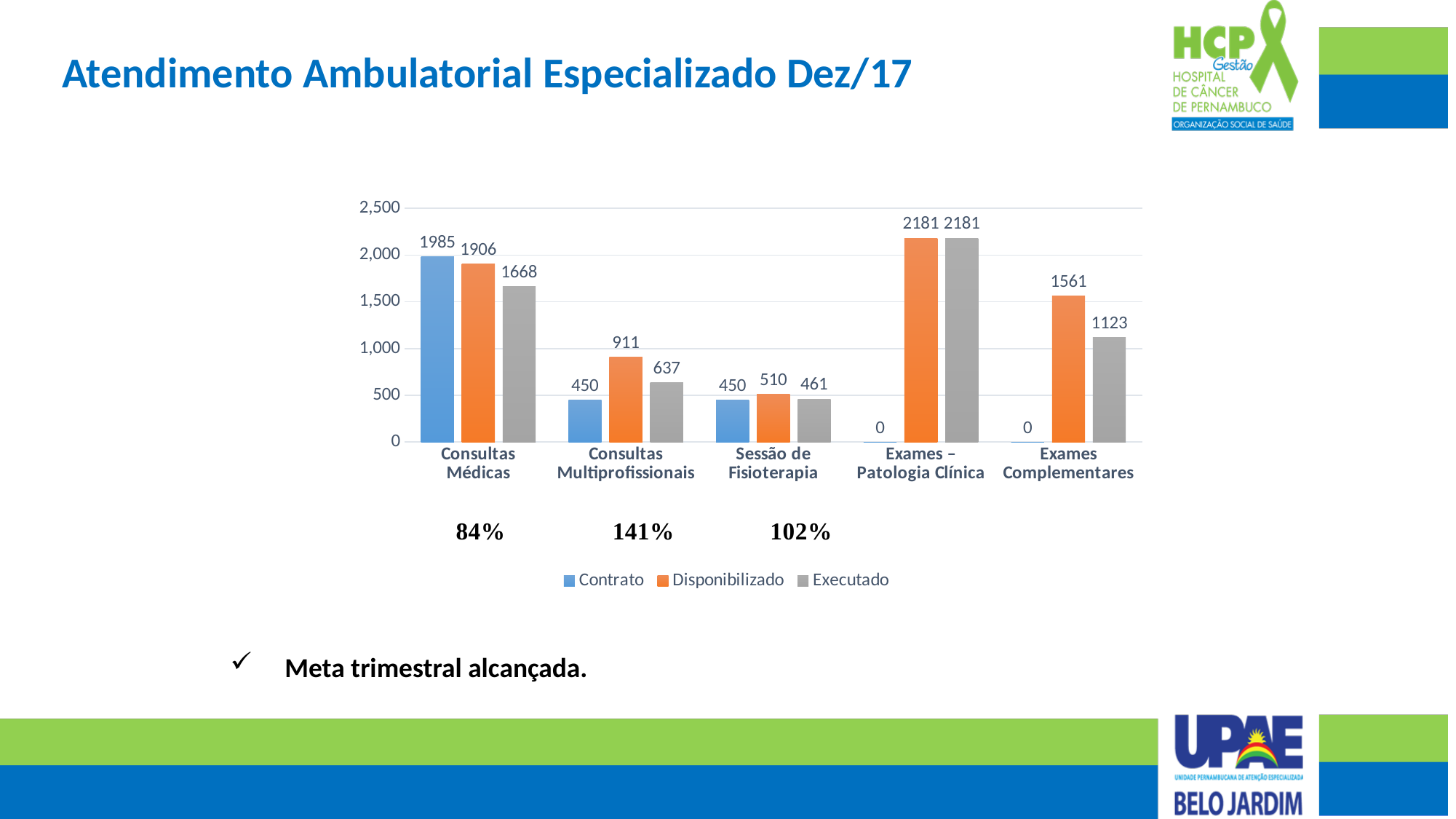
How many series does the legend list? 3 Which category has the highest Executado value? Exames – Patologia Clínica What is the difference between the Disponibilizado and Executado values for Consultas Médicas? 238 What is the Executado value for Exames Complementares? 1123 What kind of chart is shown on the slide? Bar chart Which series is shown in orange in the legend? Disponibilizado Which category has the lowest Disponibilizado value? Sessão de Fisioterapia How many categories are shown on the x axis? 5 What is the Contrato value for Exames – Patologia Clínica? 0 Which is larger for Sessão de Fisioterapia: the Contrato value or the Executado value? Executado What is the Contrato value for Consultas Médicas? 1985 What is the Disponibilizado value for Consultas Multiprofissionais? 911